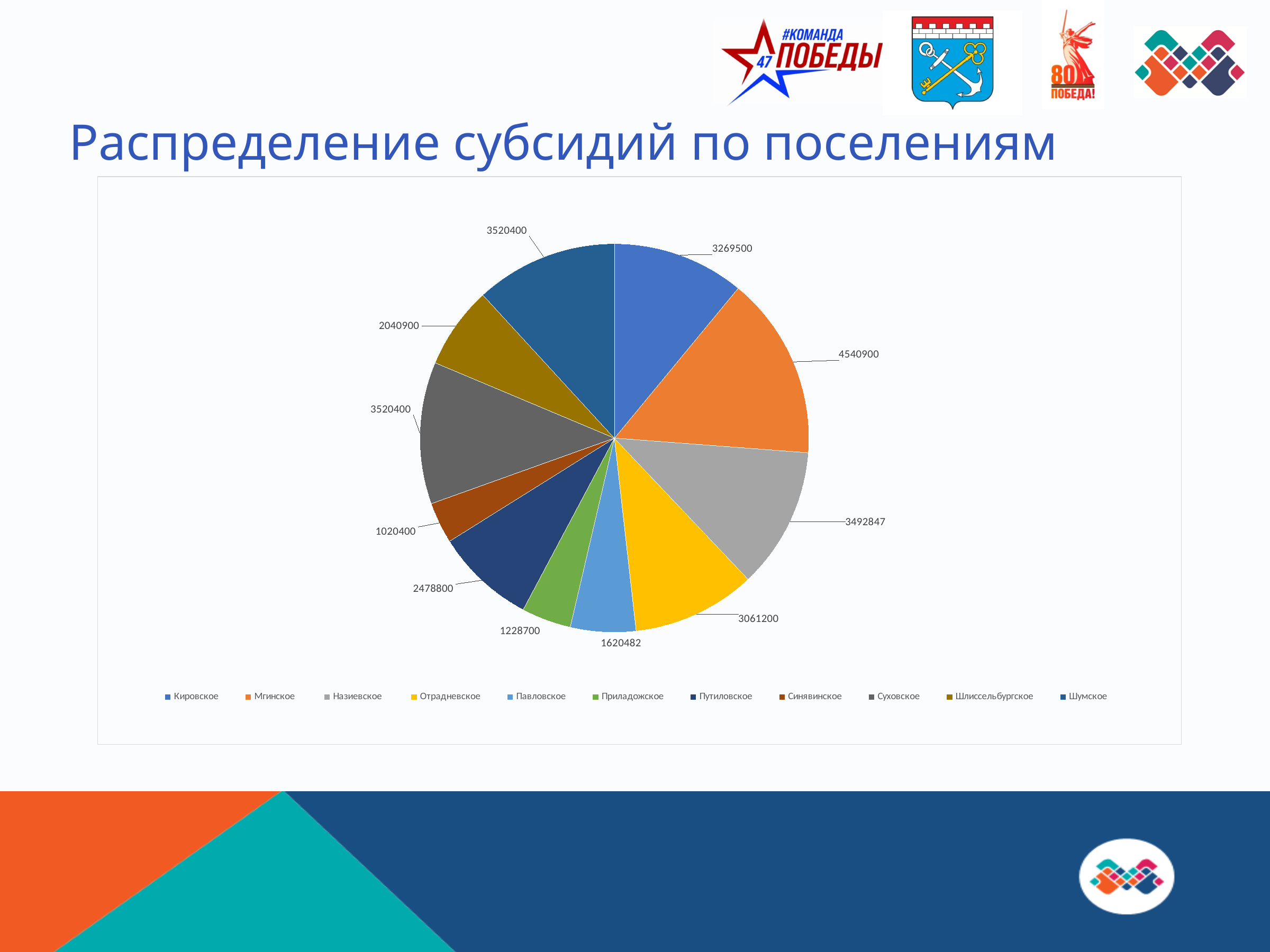
What is the value for Мгинское? 4540900 Which settlement has the largest subsidy? Мгинское What is the value for Павловское? 1620482 What is the value for Назиевское? 3492847 What is the title of the chart on the slide? Распределение субсидий по поселениям Which settlement has the smallest subsidy? Синявинское What is the value for Синявинское? 1020400 What is the value for Кировское? 3269500 What is the difference between the values for Мгинское and Отрадневское? 1479700 Which is larger, the value for Путиловское or the value for Шлиссельбургское? Путиловское How many settlements (slices) does the pie chart show? 11 What kind of chart is shown on the slide? Pie chart